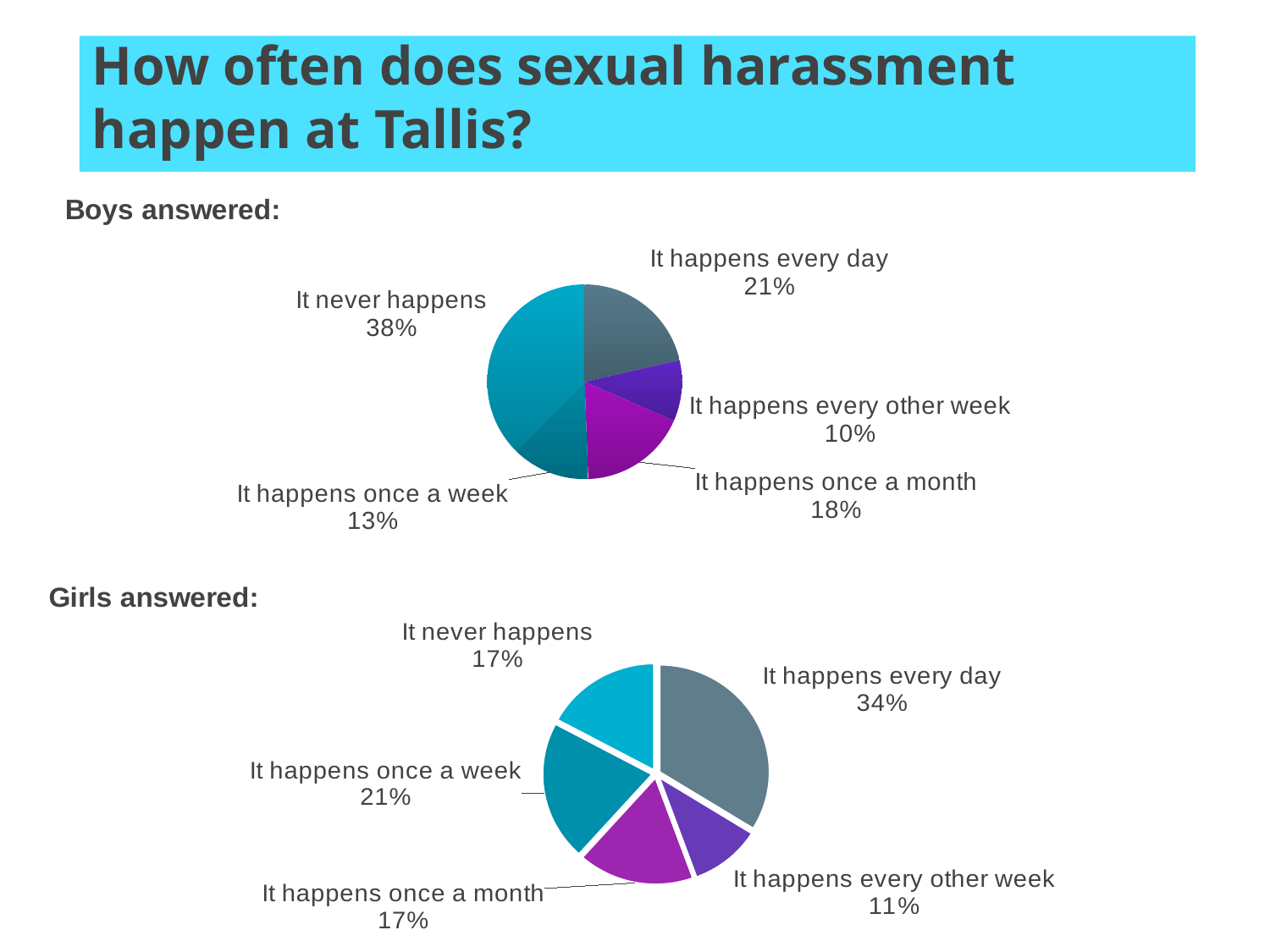
In the 'Girls answered' pie chart, what is the difference between 'It happens every day' and 'It never happens'? 17% In the 'Boys answered' pie chart, which category has the largest share? It never happens In the 'Boys answered' pie chart, what is the difference between 'It happens every day' and 'It happens once a week'? 8% In the 'Boys answered' pie chart, which category has the smallest share? It happens every other week What type of chart is used for 'Boys answered'? Pie chart In the 'Girls answered' pie chart, what percentage is shown for 'It happens every day'? 34% In the 'Boys answered' pie chart, what percentage is shown for 'It never happens'? 38% Which is larger in the 'Boys answered' pie chart: 'It happens once a month' or 'It happens every other week'? It happens once a month How many pie charts are on the slide? 2 How many slices does the 'Girls answered' pie chart have? 5 In the 'Girls answered' pie chart, which category has the smallest share? It happens every other week In the 'Girls answered' pie chart, what share does 'It happens once a week' have? 21%